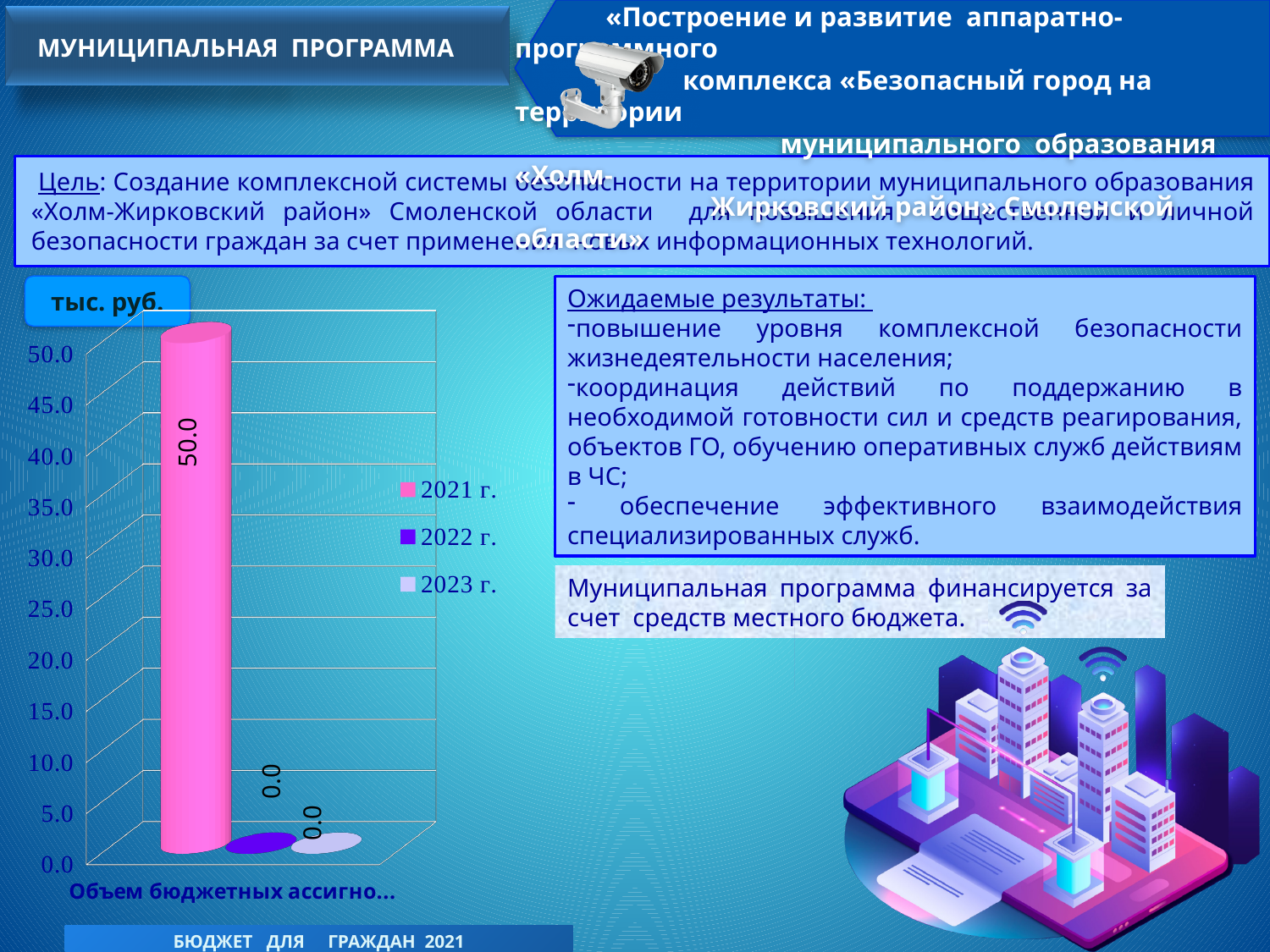
Is the value for 2021 г. greater or less than 45.0? greater What unit is shown above the chart? тыс. руб. What is the value for 2023 г. in the chart? 0.0 What is the difference between the values for 2021 г. and 2022 г.? 50.0 What is the highest value shown on the chart's vertical axis? 50.0 Which year has the highest value in the chart? 2021 г. What is the value for 2021 г. in the chart? 50.0 Which is larger, the value for 2021 г. or the value for 2023 г.? 2021 г. What is the total of the values for 2021 г., 2022 г. and 2023 г.? 50.0 How many series does the chart legend list? 3 What kind of chart is shown on the slide? bar chart What is the value for 2022 г. in the chart? 0.0